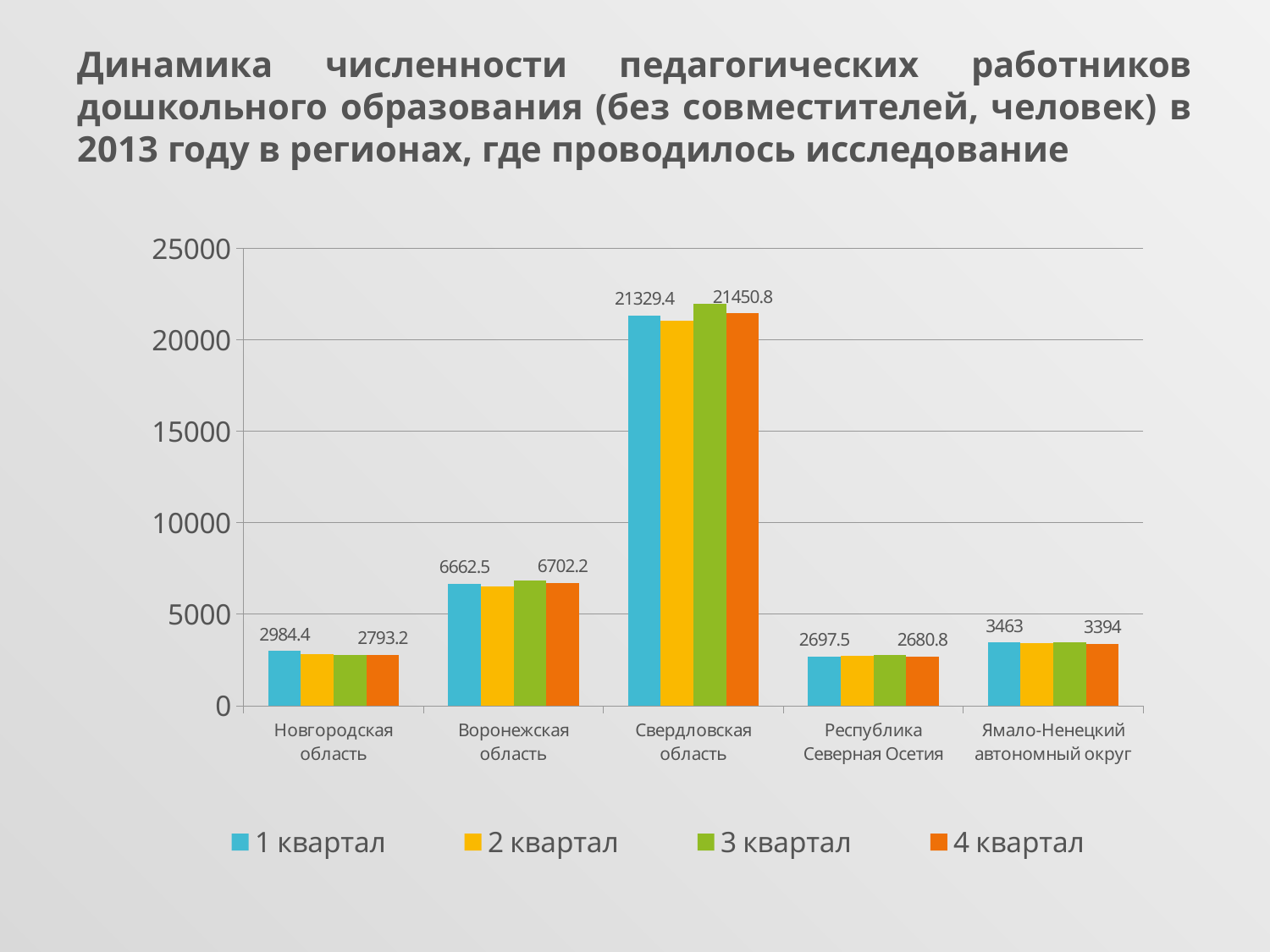
What kind of chart is shown on the slide? bar chart Which is larger for Воронежская область: the 1 квартал value or the 4 квартал value? 4 квартал Which region has the lowest value in 4 квартал? Республика Северная Осетия Is the 3 квартал value for Свердловская область greater or less than 20000? greater What is the value for Свердловская область in 4 квартал? 21450.8 What is the value for Республика Северная Осетия in 4 квартал? 2680.8 Which region has the highest value in 1 квартал? Свердловская область What is the value for Ямало-Ненецкий автономный округ in 1 квартал? 3463 How many regions are shown on the x axis? 5 What is the value for Новгородская область in 1 квартал? 2984.4 How many series does the legend list? 4 What is the difference between the 1 квартал and 4 квартал values for Новгородская область? 191.2